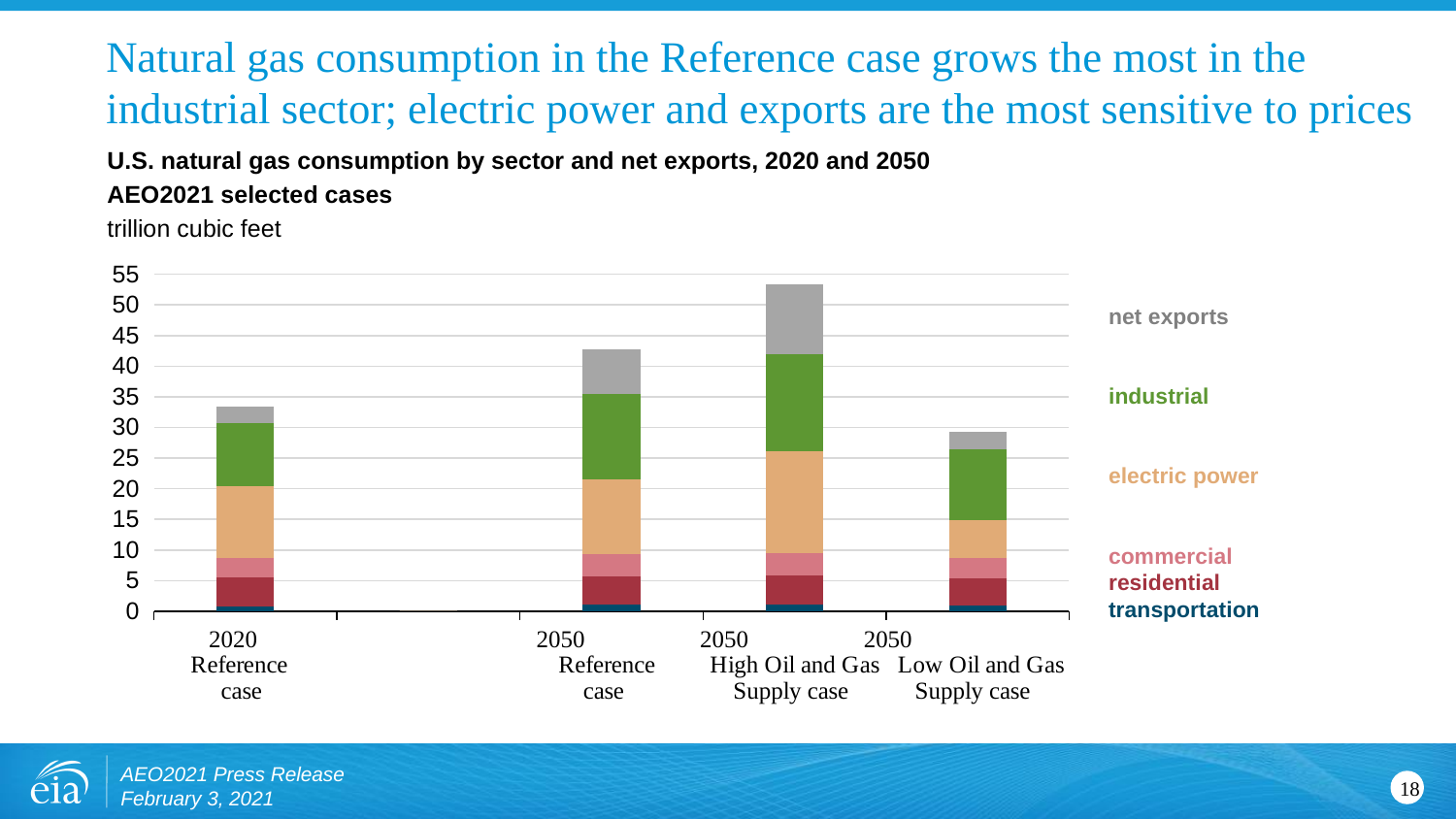
Is the total for the 2050 Low Oil and Gas Supply case greater or less than 35? less How many bars (cases) are plotted in the chart? 4 Which series is shown at the top of each stacked bar? net exports Which is larger, the total for the 2050 Reference case or the total for the 2050 Low Oil and Gas Supply case? 2050 Reference case What unit of measurement is used on the chart's y axis? trillion cubic feet Is the total for the 2020 Reference case greater or less than 30? greater Is the total for the 2050 Reference case greater or less than 40? greater How many series does the legend list? 6 Which case has the lowest total natural gas consumption plus net exports? 2050 Low Oil and Gas Supply case What kind of chart is shown on the slide? stacked bar chart Which case has the highest total natural gas consumption plus net exports? 2050 High Oil and Gas Supply case